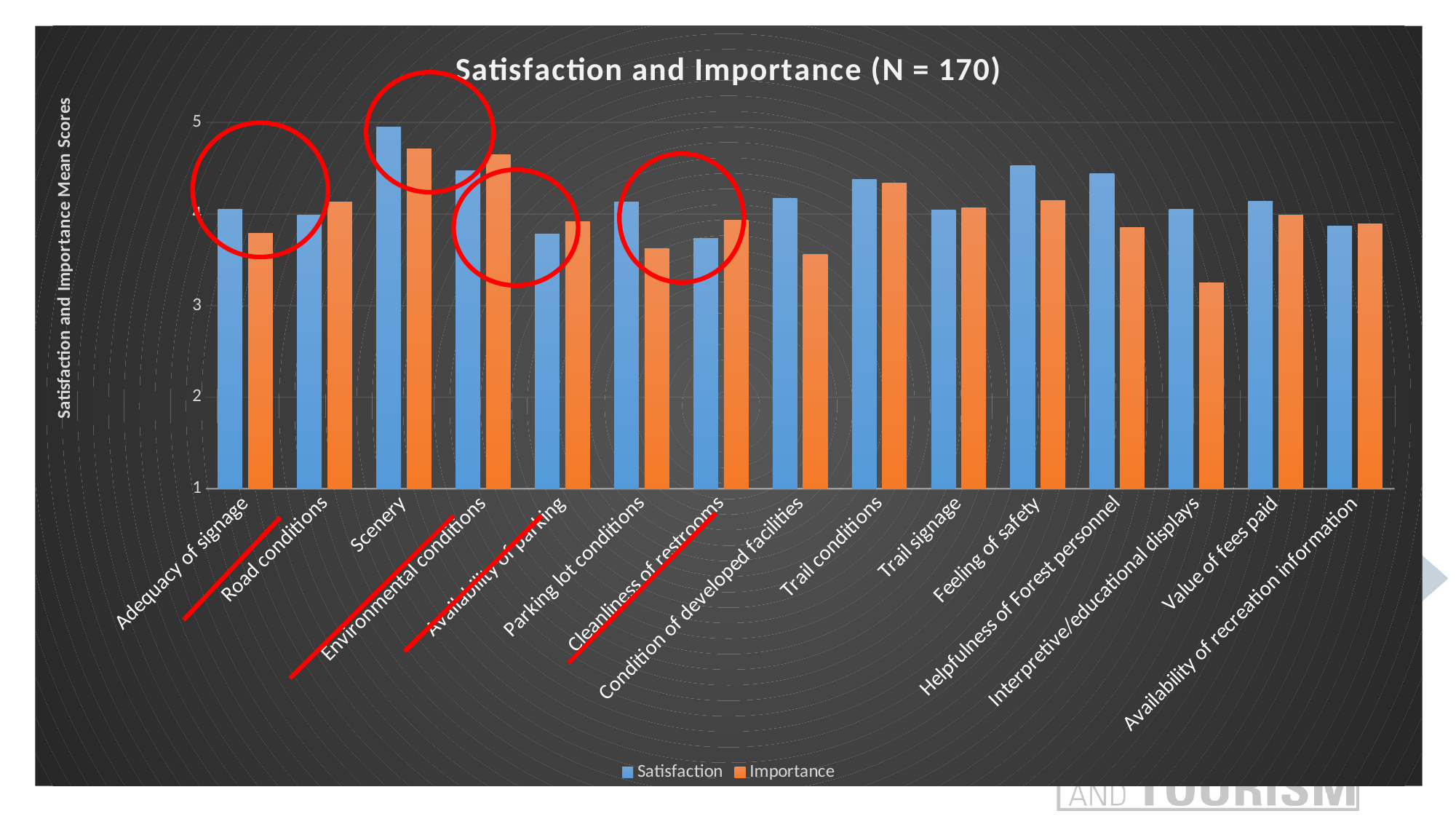
What kind of chart is shown on the slide? bar chart Is the Satisfaction value for Scenery greater or less than 4? greater For Cleanliness of restrooms, which is larger: Satisfaction or Importance? Importance Is the Satisfaction value for Feeling of safety greater or less than 4? greater Which category has the highest Satisfaction value? Scenery What is the title of the chart? Satisfaction and Importance (N = 170) Is the Importance value for Interpretive/educational displays greater or less than 4? less For Condition of developed facilities, which is larger: Satisfaction or Importance? Satisfaction How many series does the legend list? 2 How many categories are shown on the x axis? 15 Which category has the lowest Importance value? Interpretive/educational displays